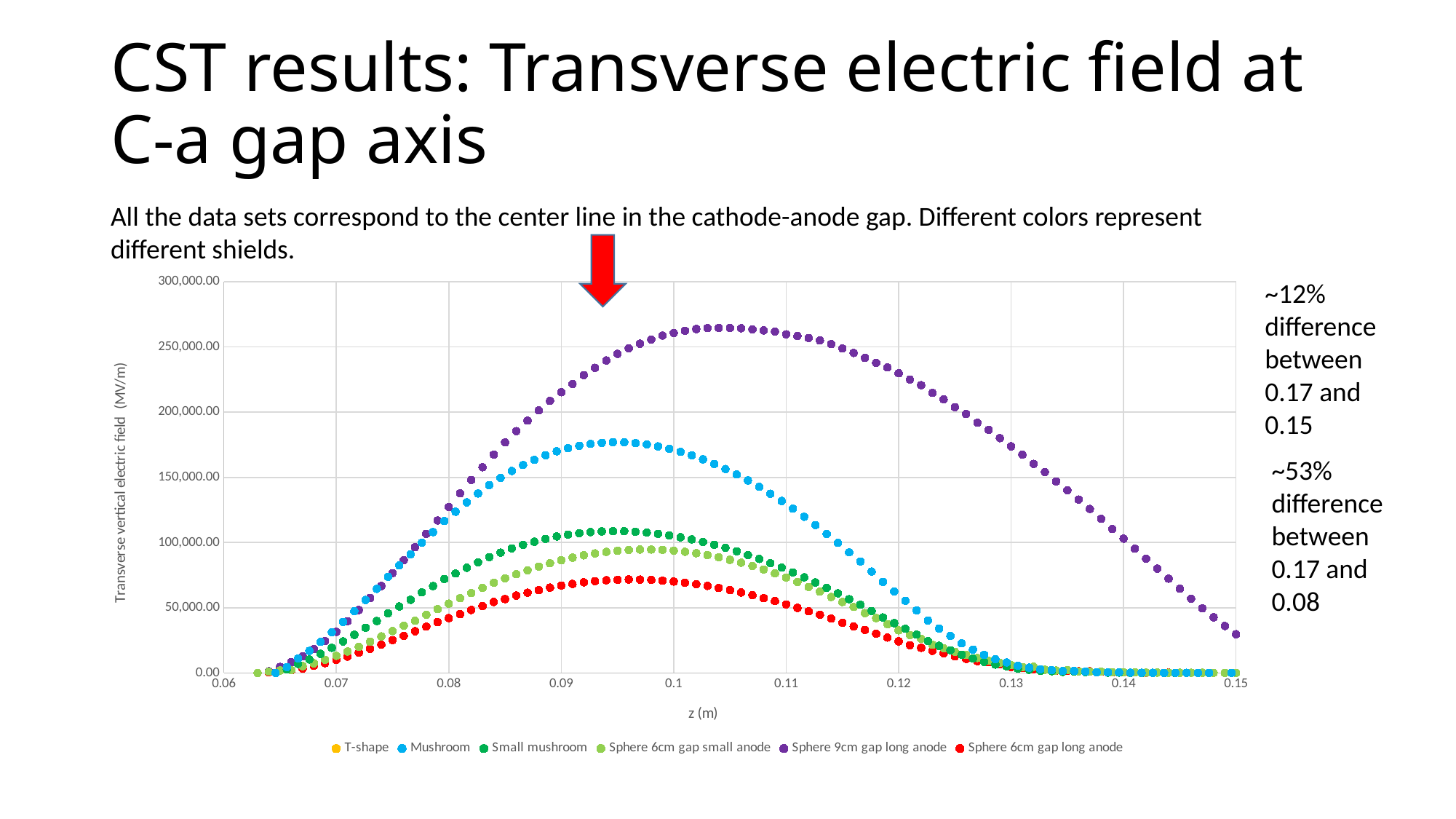
Which series reaches the highest transverse electric field value? Sphere 9cm gap long anode Is the peak value of the Mushroom series greater or less than 150,000.00? greater Is the peak value of the Sphere 9cm gap long anode series greater or less than 250,000.00? greater How does the Sphere 9cm gap long anode series behave as z increases from 0.06 to 0.15? rises to a peak then falls How many series does the legend list? 6 Which series has a higher peak value, Mushroom or Small mushroom? Mushroom What is the label of the y axis? Transverse vertical electric field (MV/m) Is the peak value of the Mushroom series greater or less than 200,000.00? less What is the label of the x axis? z (m) What kind of chart is shown on the slide? scatter chart Which series has the lowest peak transverse electric field among the visible curves? Sphere 6cm gap long anode